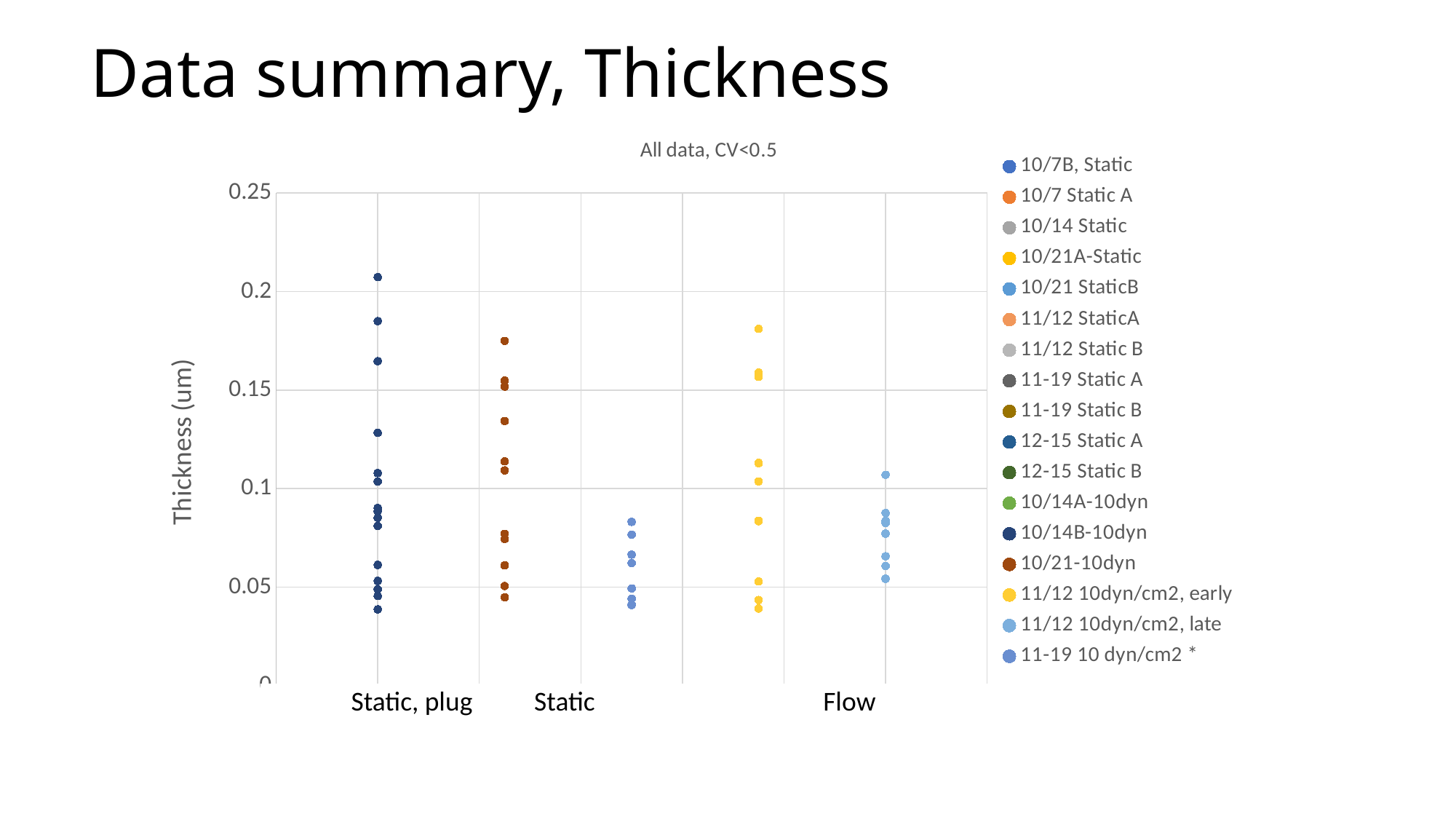
How many series does the legend list? 17 Is the highest point in the 'Static, plug' column greater or less than 0.2? greater How many category labels are shown along the x axis? 3 What is the label of the y axis? Thickness (um) What is the title of the chart? All data, CV<0.5 Is the lowest yellow (11/12 10dyn/cm2, early) point greater or less than 0.05? less Is the highest light blue (11/12 10dyn/cm2, late) point in the Flow group greater or less than 0.15? less What kind of chart is shown on the slide? scatter chart